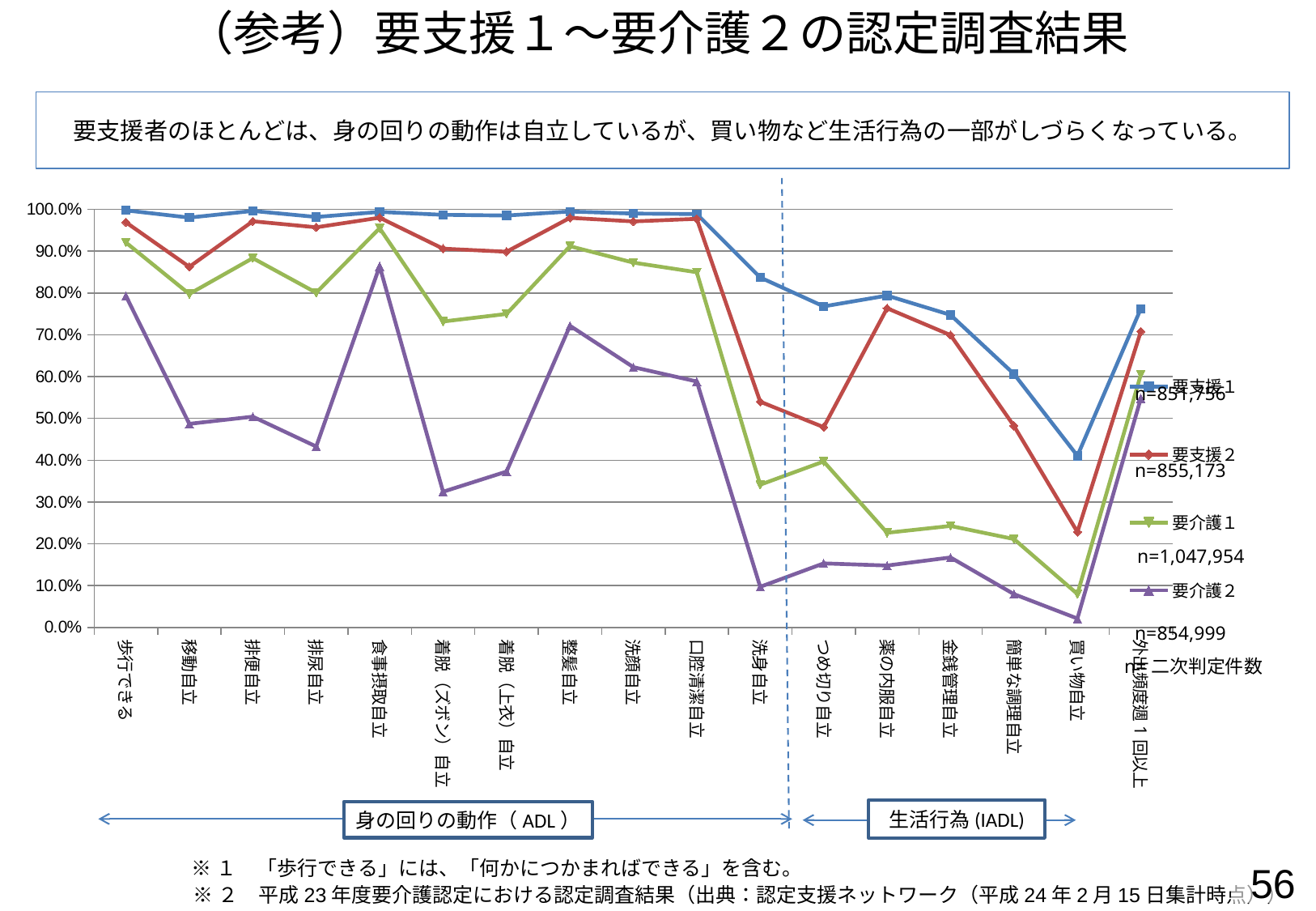
For 要介護2, which category has the highest value? 食事摂取自立 What n value is shown next to the legend entry 要介護1? n=1,047,954 Is the value for 要支援1 at 洗身自立 greater or less than 80.0%? greater Is the value for 要介護1 at 洗身自立 greater or less than 30.0%? greater At 薬の内服自立, which is larger: 要介護1 or 要介護2? 要介護1 What kind of chart is shown on the slide? line chart Is the value for 要介護2 at 買い物自立 greater or less than 10.0%? less For 要支援1, do the values rise or fall from 口腔清潔自立 to 買い物自立? fall For 要介護2, which category has the lowest value? 買い物自立 How many categories are plotted along the x axis? 17 How many series does the legend list? 4